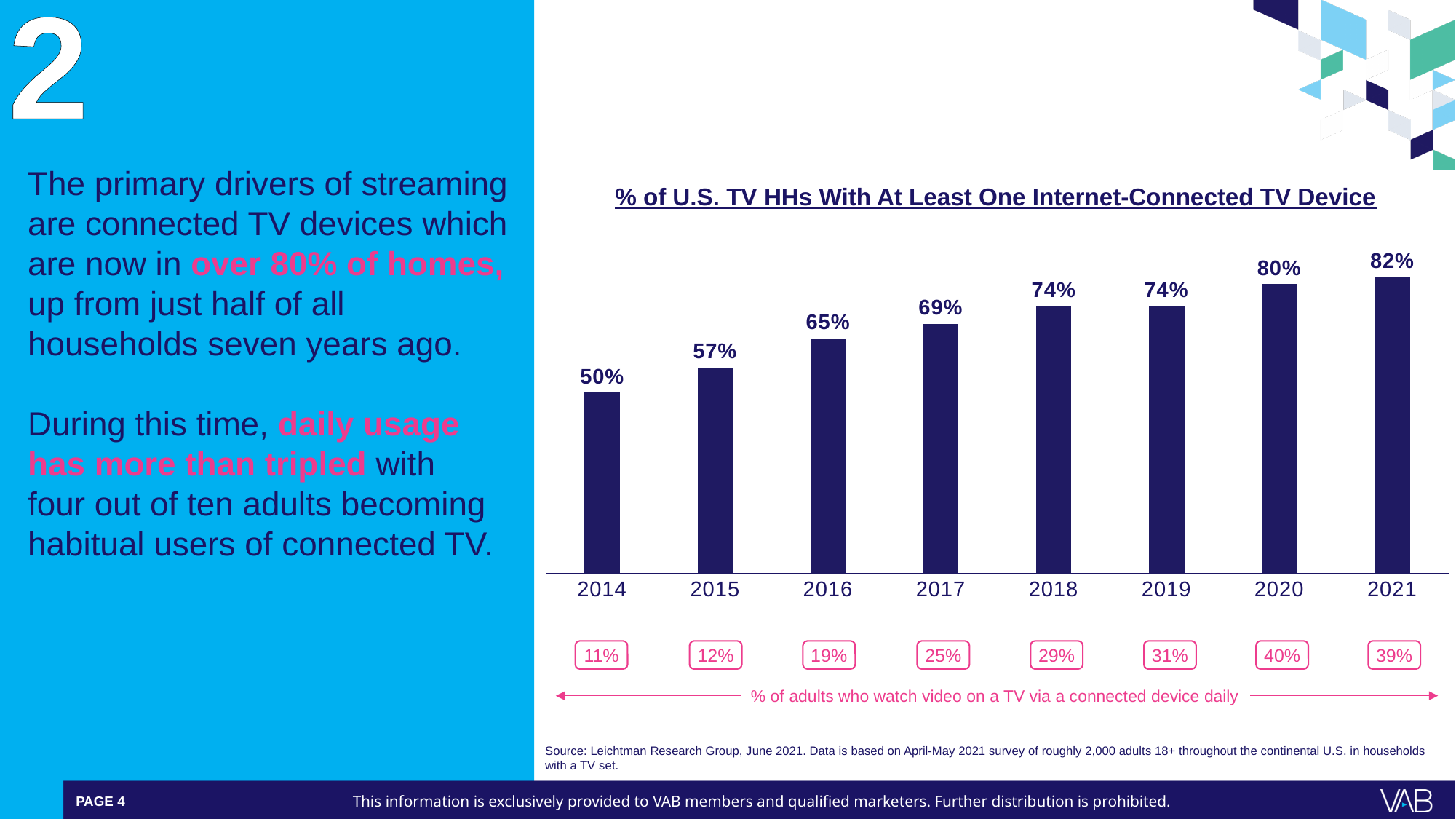
What is the value for 2017 in the chart '% of U.S. TV HHs With At Least One Internet-Connected TV Device'? 69% What is the value for 2020 in the chart '% of U.S. TV HHs With At Least One Internet-Connected TV Device'? 80% In the chart '% of U.S. TV HHs With At Least One Internet-Connected TV Device', which is larger, the value for 2016 or the value for 2018? 2018 Which year has the lowest value in the chart '% of U.S. TV HHs With At Least One Internet-Connected TV Device'? 2014 How many years are shown on the x axis of the chart '% of U.S. TV HHs With At Least One Internet-Connected TV Device'? 8 What is the value for 2014 in the chart '% of U.S. TV HHs With At Least One Internet-Connected TV Device'? 50% What is the difference between the 2021 and 2014 values in the chart '% of U.S. TV HHs With At Least One Internet-Connected TV Device'? 32% Which year has the highest value in the chart '% of U.S. TV HHs With At Least One Internet-Connected TV Device'? 2021 Below the chart, what is the % of adults who watch video on a TV via a connected device daily shown for 2020? 40% What is the difference between the 2016 and 2015 values in the chart '% of U.S. TV HHs With At Least One Internet-Connected TV Device'? 8% What kind of chart is '% of U.S. TV HHs With At Least One Internet-Connected TV Device'? Bar chart Do the values in the chart '% of U.S. TV HHs With At Least One Internet-Connected TV Device' generally rise or fall from 2014 to 2021? Rise